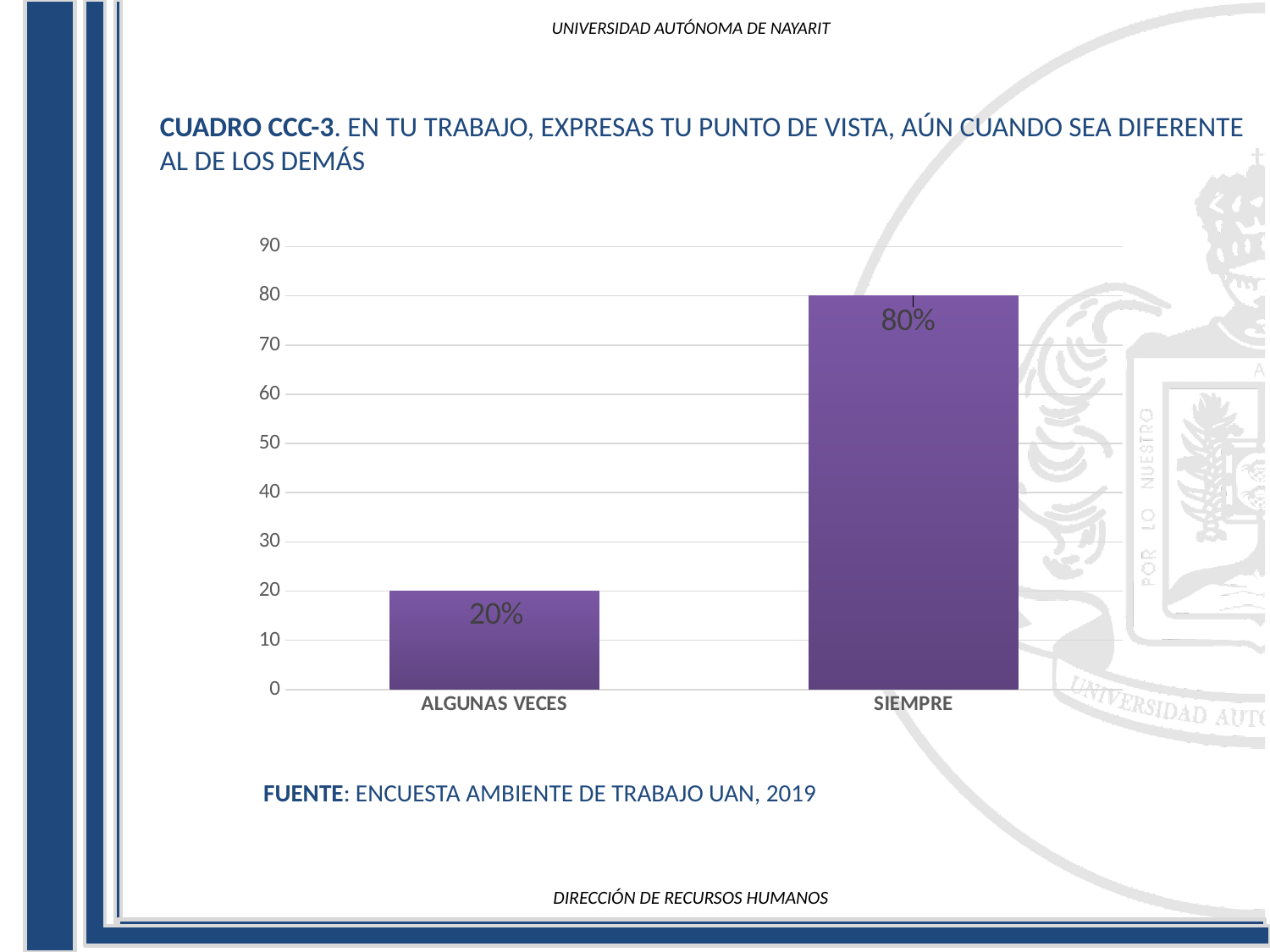
Is the value for SIEMPRE greater or less than 50? greater What is the value for SIEMPRE? 80% What is the difference between the values for SIEMPRE and ALGUNAS VECES? 60% How many categories are shown on the x axis? 2 Is the value for ALGUNAS VECES greater or less than 30? less What is the highest value shown on the vertical axis? 90 Which category has the lowest value? ALGUNAS VECES Which category has the highest value? SIEMPRE What is the value for ALGUNAS VECES? 20% Which is larger, the value for ALGUNAS VECES or the value for SIEMPRE? SIEMPRE What is the source cited below the chart? ENCUESTA AMBIENTE DE TRABAJO UAN, 2019 What kind of chart is shown on the slide? bar chart